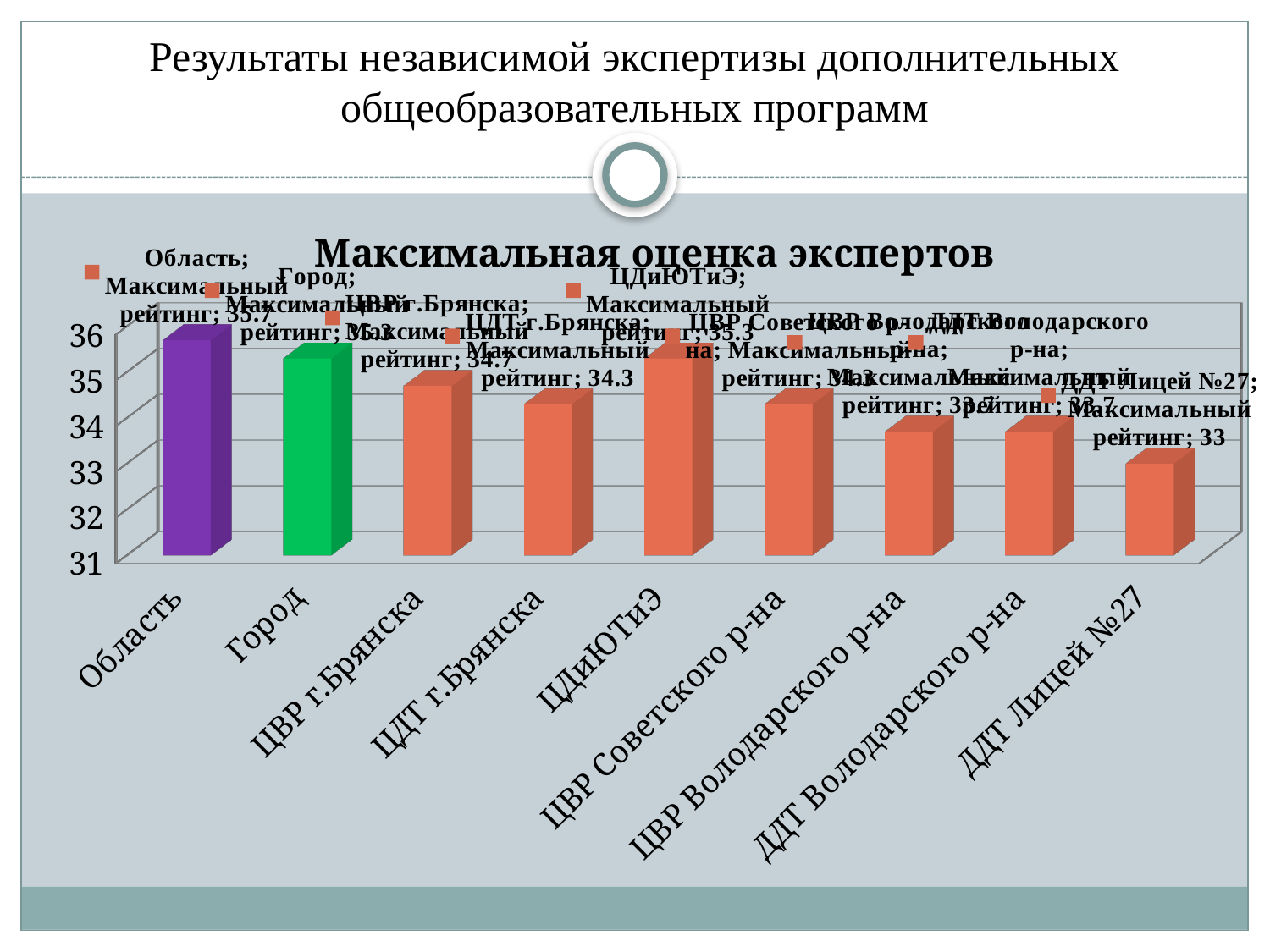
How many categories are plotted on the chart? 9 What is the value for ДДТ Лицей №27? 33 What is the value for ЦВР г.Брянска? 34.7 Which category has the lowest value? ДДТ Лицей №27 Which category has the highest value? Область What is the value for ЦДиЮТиЭ? 35.3 Which is larger, the value for ЦВР г.Брянска or the value for ЦДТ г.Брянска? ЦВР г.Брянска What is the title of the chart? Максимальная оценка экспертов What is the difference between the values for Область and ДДТ Лицей №27? 2.7 What is the value for Область? 35.7 What is the value for ЦДТ г.Брянска? 34.3 What kind of chart is shown on the slide? Bar chart